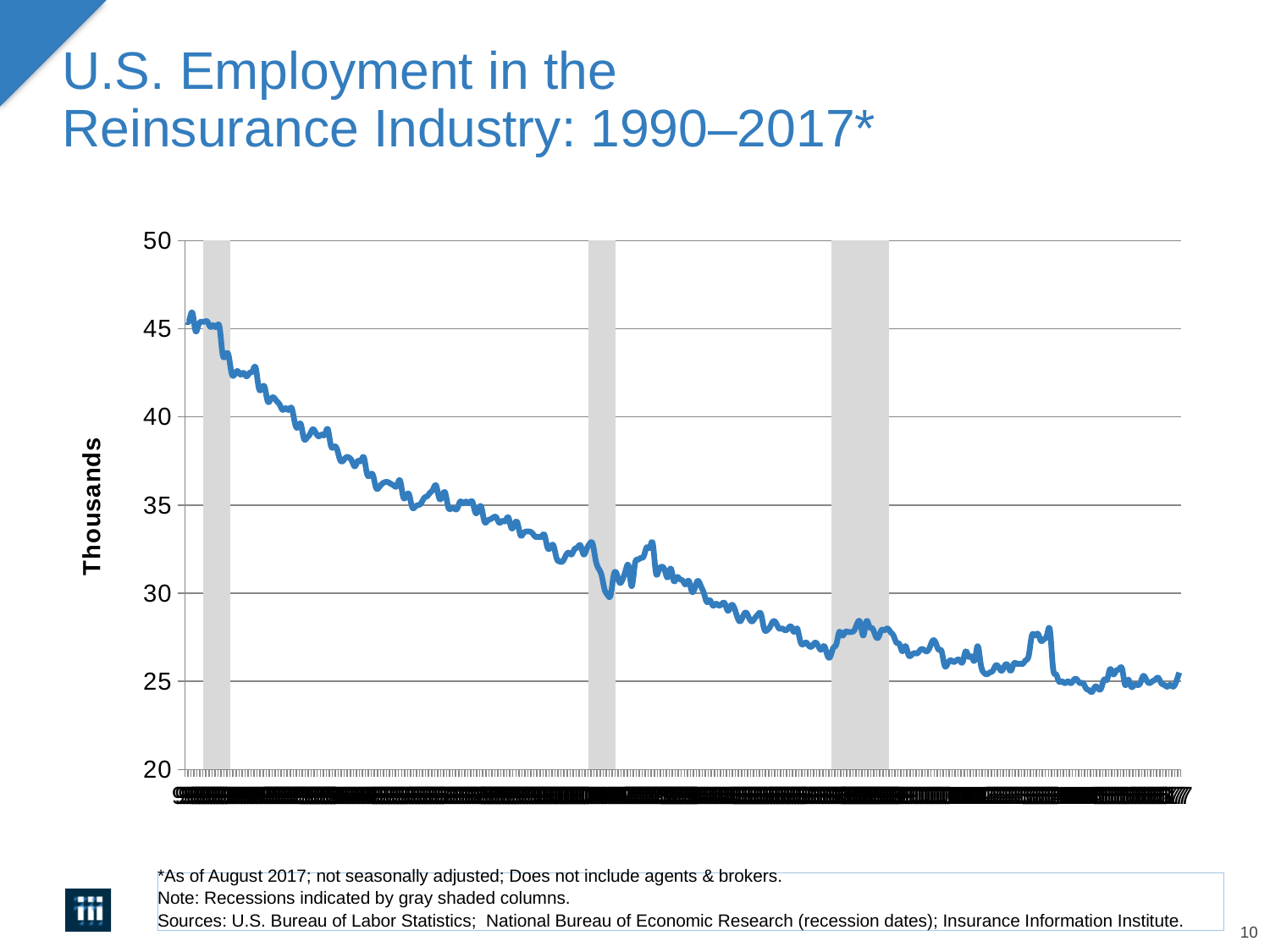
Is the highest point of the line greater or less than 50? less What is the highest value shown on the vertical axis? 50 How many gray shaded recession columns appear on the chart? 3 What is the label on the vertical axis of the chart? Thousands Is the value at the start of the series (left end of the line) greater or less than 40? greater What is the title of the chart? U.S. Employment in the Reinsurance Industry: 1990–2017* Overall, do the values rise or fall from left to right along the x axis? fall Which end of the line is higher, the left end or the right end? the left end Is the value at the end of the series (right end of the line) greater or less than 30? less What kind of chart is shown on the slide? line chart